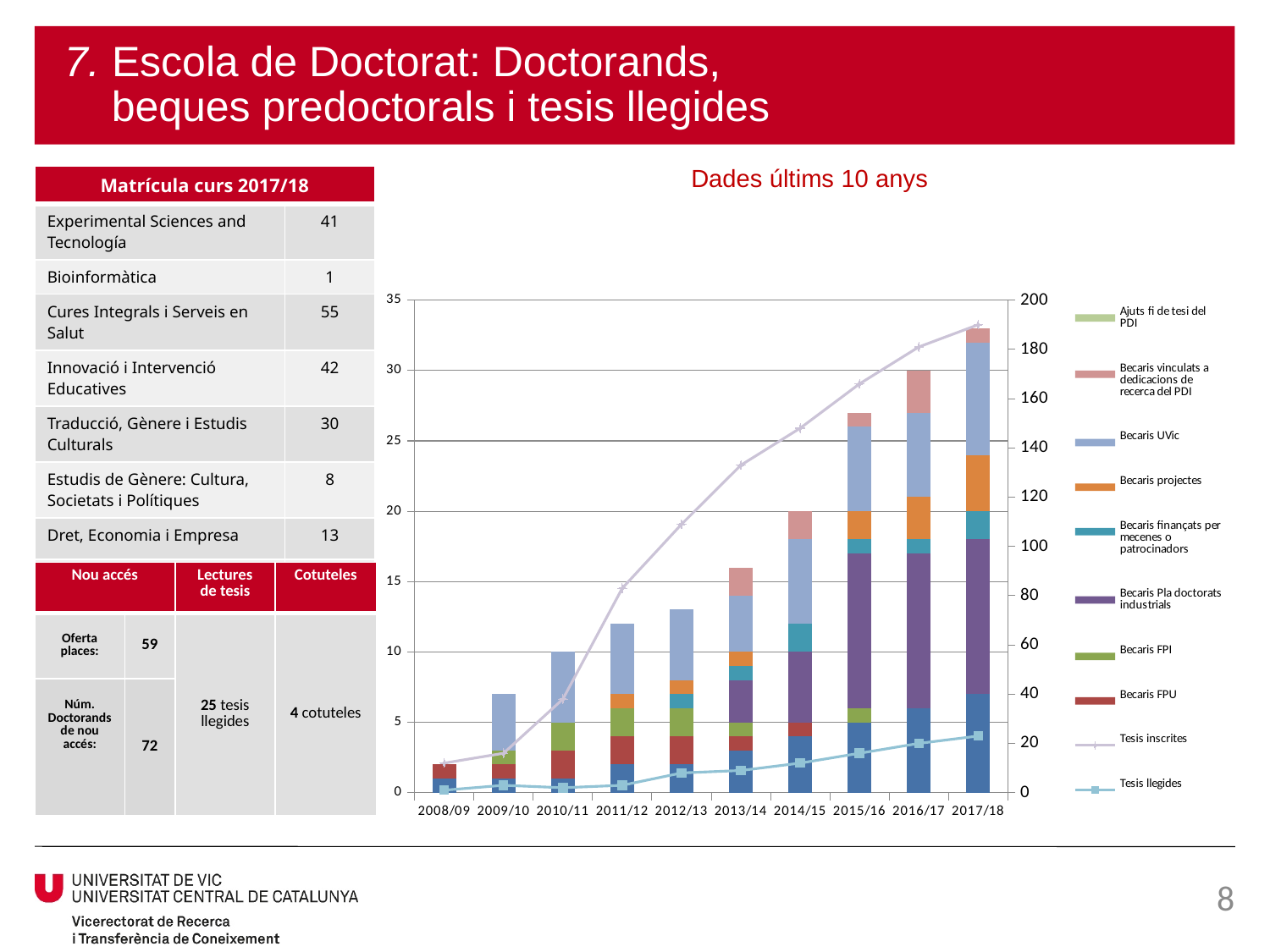
Which stacked bar is taller, 2015/16 or 2012/13? 2015/16 Is the Tesis inscrites value for 2017/18 greater or less than 180 on the right axis? greater Which academic year has the shortest stacked bar in the chart? 2008/09 What is the title of the chart on the slide? Dades últims 10 anys Does the Tesis inscrites line rise or fall from 2008/09 to 2017/18? rise What kind of chart is shown on the slide? stacked bar chart (with two line series) Is the total height of the stacked bar for 2017/18 greater or less than 30 on the left axis? greater How many academic years are shown along the x axis of the chart? 10 How many series does the chart legend list? 10 Is the Tesis inscrites value for 2008/09 greater or less than 20 on the right axis? less Which academic year has the tallest stacked bar in the chart? 2017/18